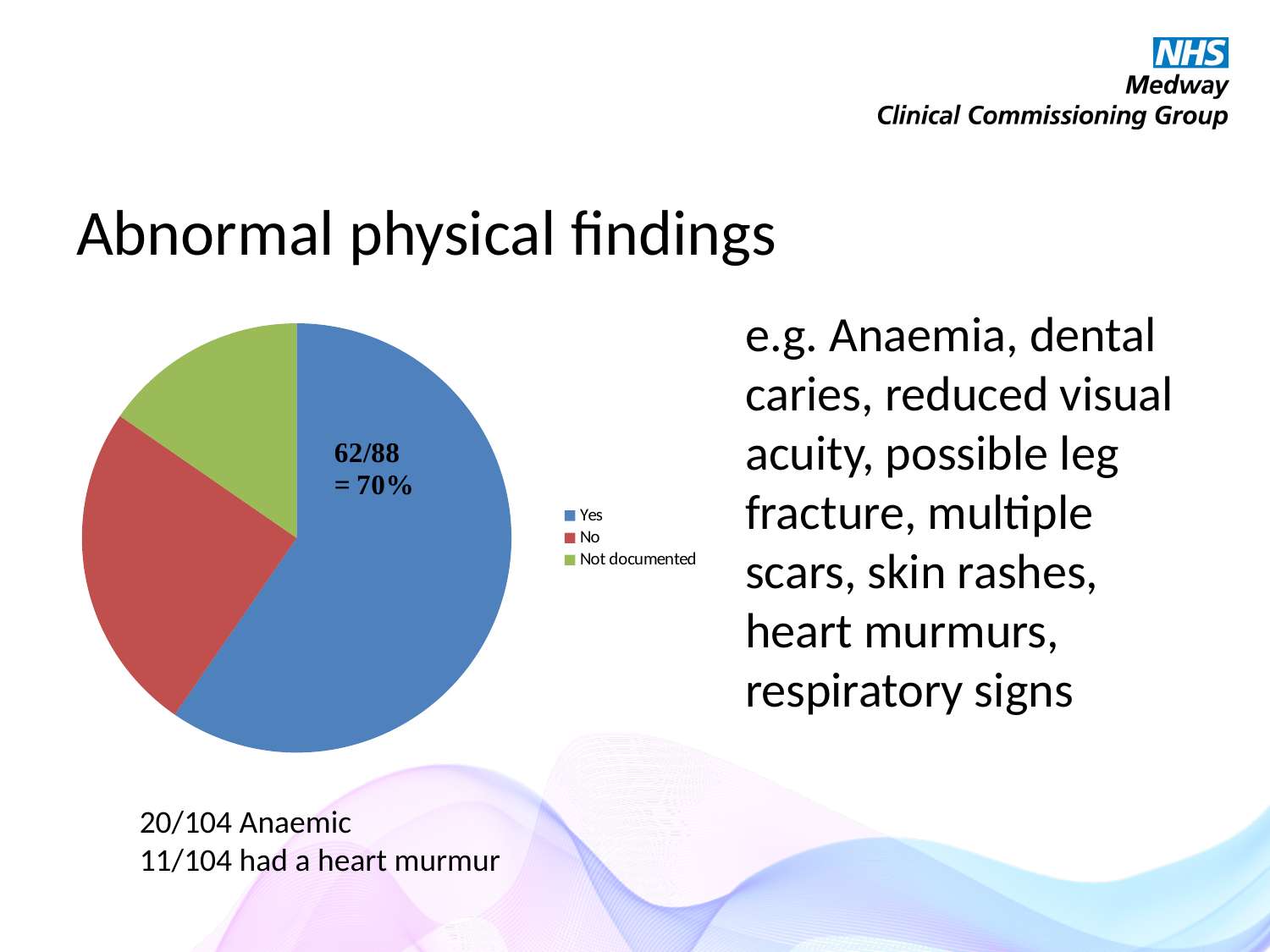
What share of the pie does the Yes slice represent? 70% Which category has the largest slice of the pie chart? Yes Which legend entry is shown in red in the pie chart? No How many slices does the pie chart have? 3 What kind of chart is shown on the slide? pie chart Which slice is larger in the pie chart, Yes or No? Yes Which slice is larger in the pie chart, No or Not documented? No What colour is the Not documented slice in the pie chart? green Which category has the smallest slice of the pie chart? Not documented How many entries does the legend of the pie chart list? 3 What data label is printed on the Yes slice of the pie chart? 62/88 = 70%